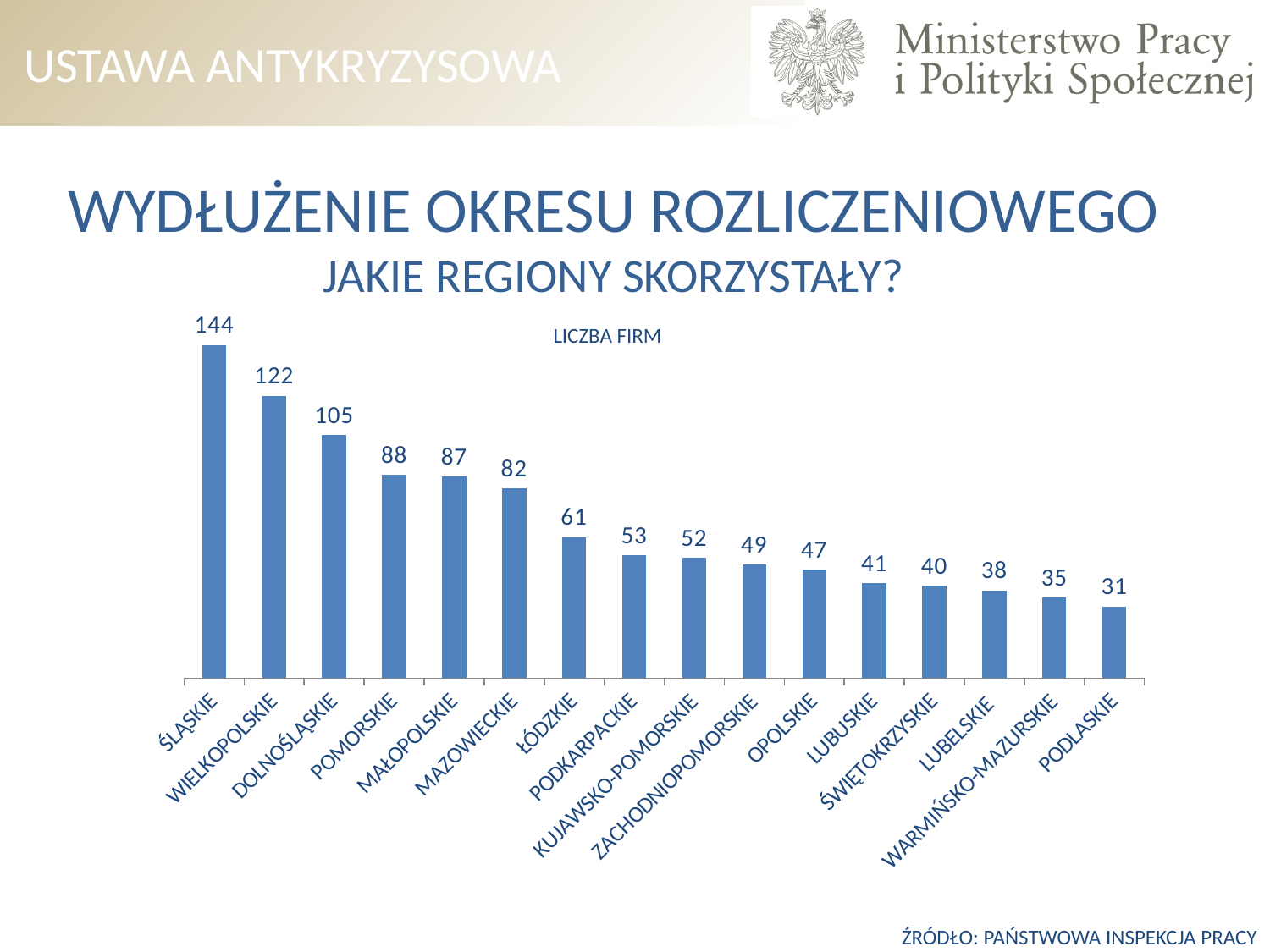
What is the value for KUJAWSKO-POMORSKIE? 52 Which region has the highest value? ŚLĄSKIE What is the difference between the values for ŚLĄSKIE and WIELKOPOLSKIE? 22 What is the value for ŚLĄSKIE? 144 What kind of chart is shown on the slide? Bar chart What is the title of the chart? LICZBA FIRM Which region has the lowest value? PODLASKIE What is the difference between the values for ŁÓDZKIE and PODLASKIE? 30 What is the value for WARMIŃSKO-MAZURSKIE? 35 What is the value for MAZOWIECKIE? 82 How many regions are shown in the chart? 16 Which has a larger value, DOLNOŚLĄSKIE or POMORSKIE? DOLNOŚLĄSKIE